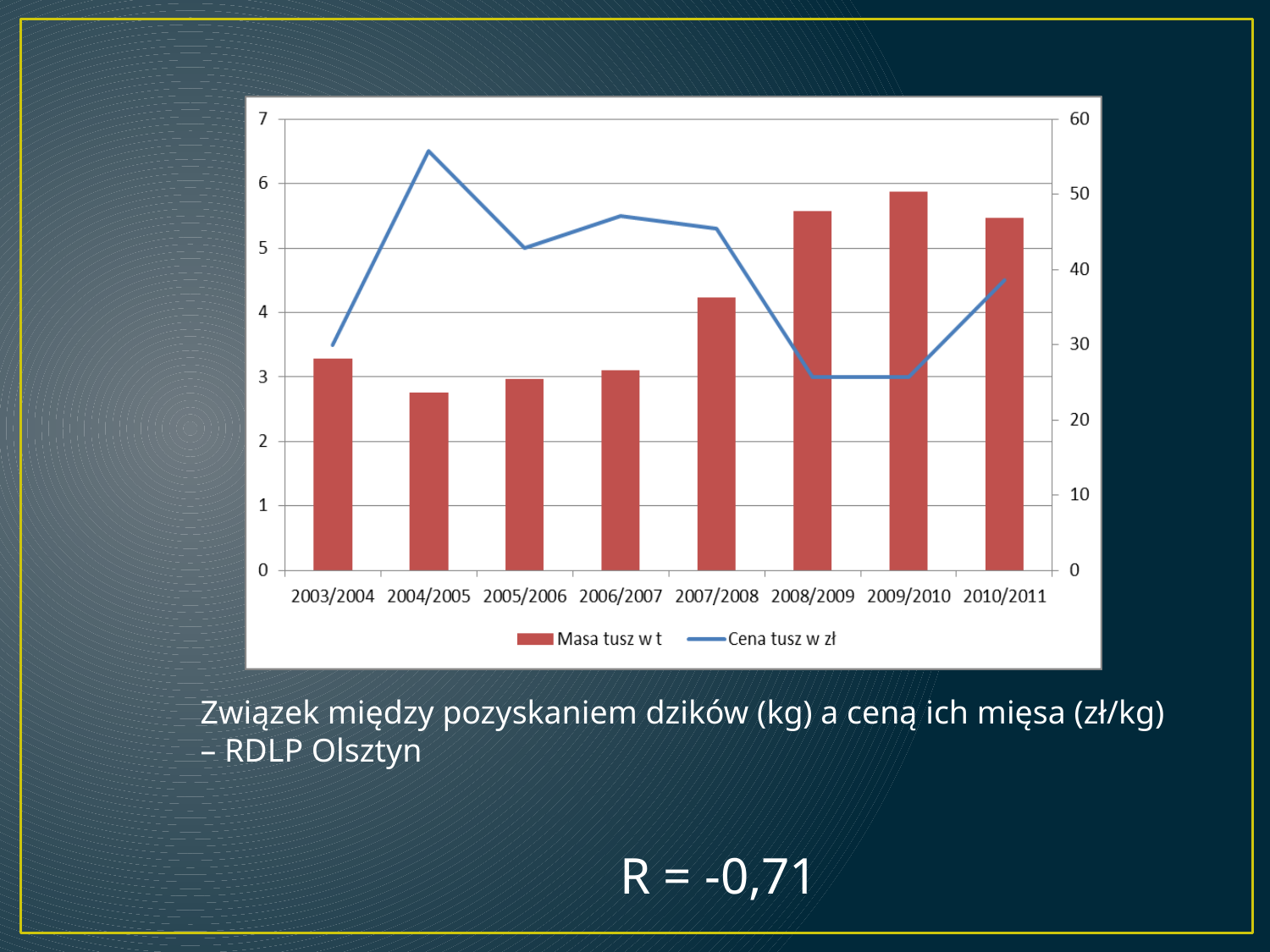
Which season has the lowest bar for "Masa tusz w t"? 2004/2005 Which season has the larger "Masa tusz w t" bar, 2007/2008 or 2010/2011? 2010/2011 How many categories (seasons) are shown on the x axis of the chart? 8 Is the "Masa tusz w t" value for 2004/2005 greater or less than 3? less How many series does the chart legend list? 2 What kinds of chart are combined in this chart? A bar chart and a line chart Is the "Cena tusz w zł" value for 2004/2005 greater or less than 50? greater Does the "Cena tusz w zł" line rise or fall between 2007/2008 and 2008/2009? fall Is the "Masa tusz w t" value for 2008/2009 greater or less than 5? greater Which series is shown as a line in the chart? Cena tusz w zł Which season has the highest bar for "Masa tusz w t"? 2009/2010 In which season does the "Cena tusz w zł" line reach its highest point? 2004/2005